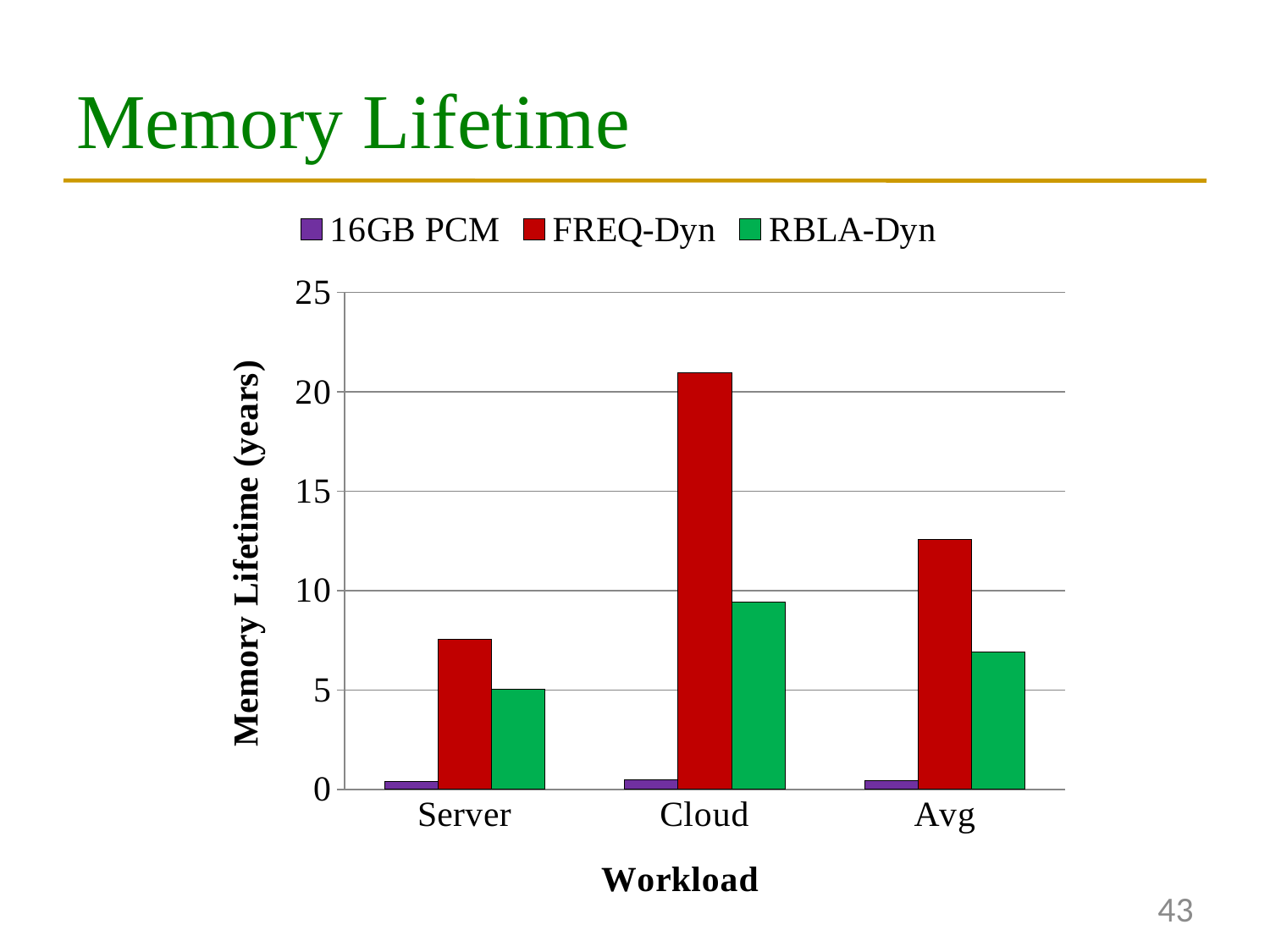
What kind of chart is shown on the slide? bar chart Which workload has the highest FREQ-Dyn memory lifetime? Cloud What is the label of the x axis? Workload Is the RBLA-Dyn value for Cloud greater or less than 10? less Which series has the lowest memory lifetime for the Cloud workload? 16GB PCM Is the FREQ-Dyn value for Avg greater or less than 10? greater Is the FREQ-Dyn value for Cloud greater or less than 20? greater How many workload categories are shown on the x axis? 3 For the Server workload, which is larger: FREQ-Dyn or RBLA-Dyn? FREQ-Dyn How many series does the legend list? 3 What is the label of the y axis? Memory Lifetime (years)